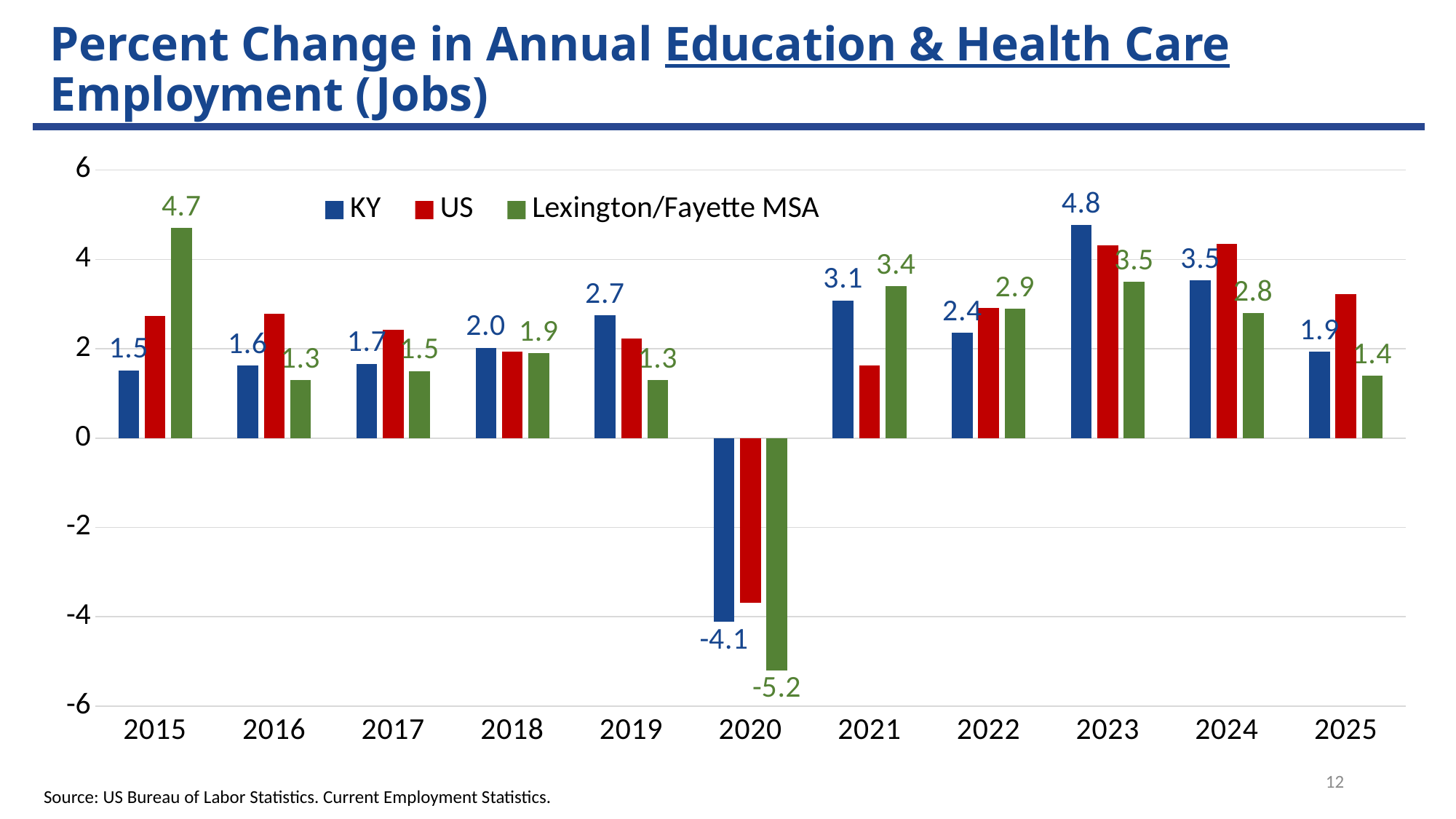
What is the value for KY in 2023? 4.8 What is the value for Lexington/Fayette MSA in 2015? 4.7 What is the value for Lexington/Fayette MSA in 2020? -5.2 Which is larger in 2021, the KY value or the Lexington/Fayette MSA value? Lexington/Fayette MSA How many years are shown on the x axis? 11 What is the difference between the KY value and the Lexington/Fayette MSA value in 2015? 3.2 How many series does the legend list? 3 In which year is the Lexington/Fayette MSA value lowest? 2020 In which year is the KY value highest? 2023 Is the US value for 2020 greater or less than -2? less What type of chart is shown on the slide? bar chart Is the US value for 2023 greater or less than 4? greater